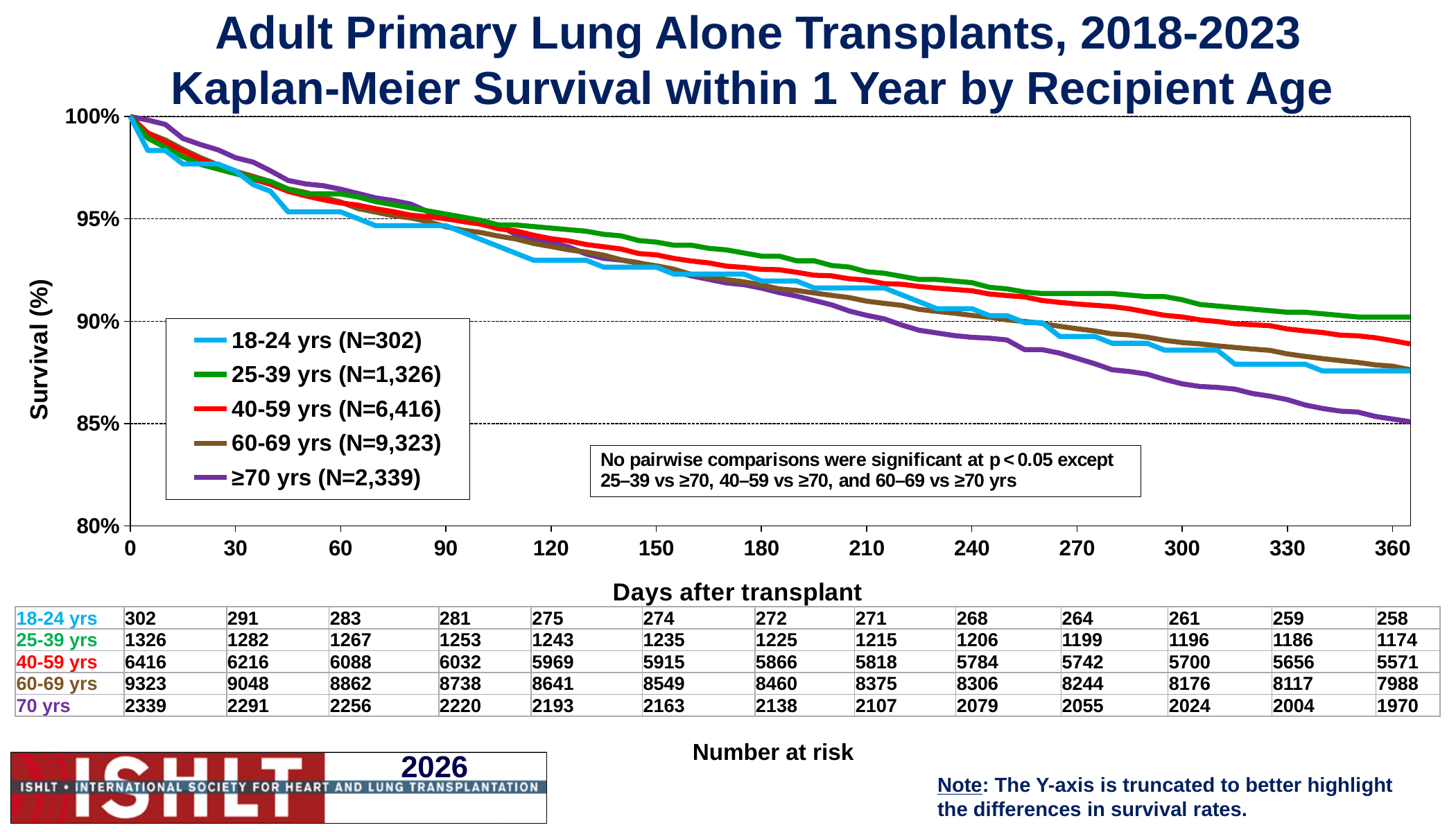
In the number at risk table, how many 18-24 yrs recipients are at risk at day 0? 302 Is the survival for the 18-24 yrs group at 360 days greater or less than 90%? less Which recipient age group has the lowest survival at 360 days after transplant? ≥70 yrs At 360 days, is survival higher for the 40-59 yrs group or the ≥70 yrs group? 40-59 yrs What kind of chart is shown on the slide? line chart What is the label of the x axis? Days after transplant According to the legend, what is the N for the 40-59 yrs group? N=6,416 How many recipient age groups does the legend list? 5 Is the survival for the 25-39 yrs group at 180 days greater or less than 90%? greater Do the survival curves rise or fall as days after transplant increase? fall Which recipient age group has the highest survival at 360 days after transplant? 25-39 yrs In the number at risk table, how many 60-69 yrs recipients are at risk at 360 days? 7988